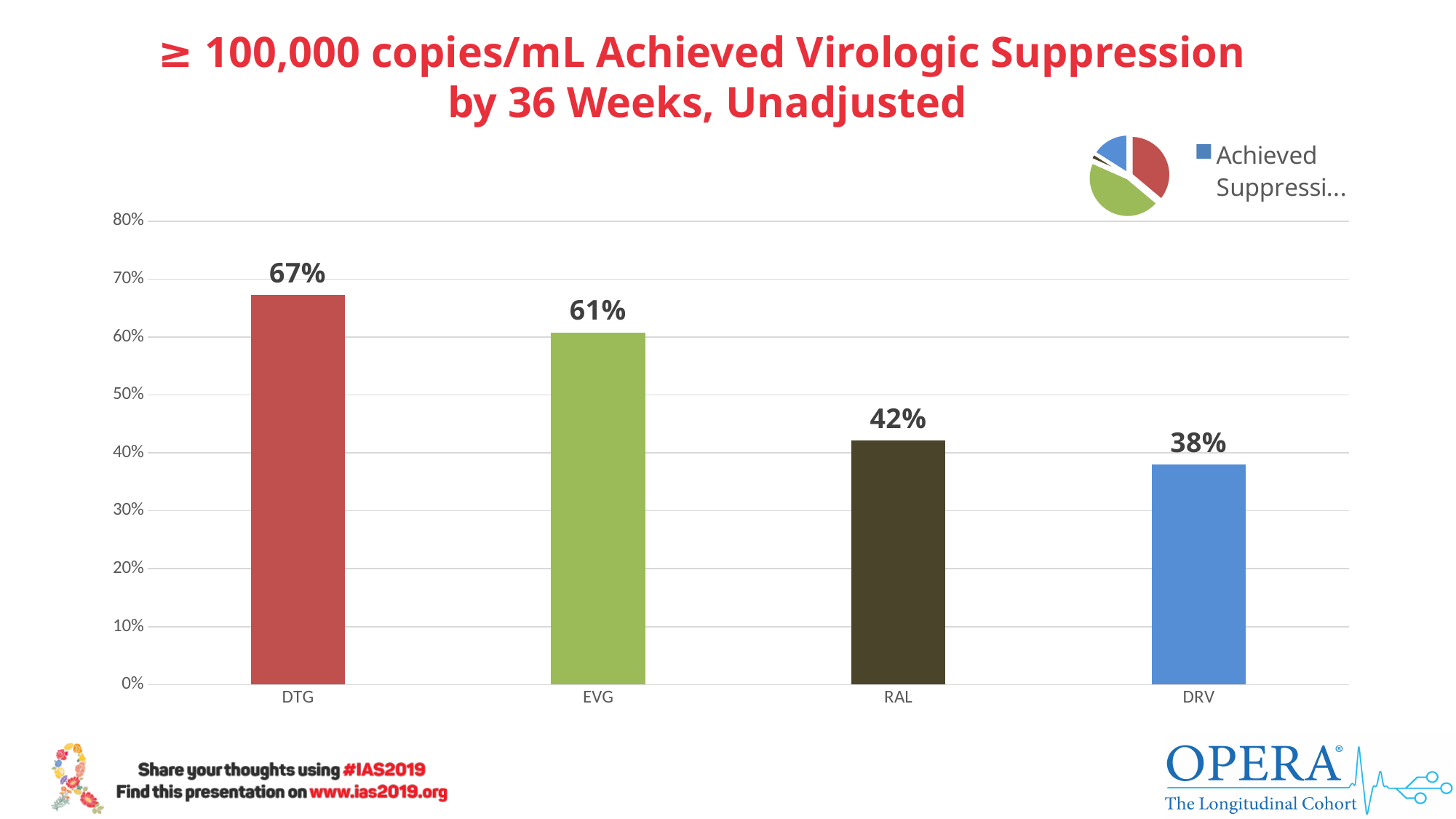
What is the difference between the values for DTG and DRV? 29% What is the value for RAL? 42% How many categories are shown on the x axis? 4 What is the value for EVG? 61% What is the difference between the values for EVG and RAL? 19% What kind of chart is this? Bar chart Do the values rise or fall from left to right along the x axis? Fall Which category has the highest value? DTG Which category has the lowest value? DRV Which is larger, the value for EVG or the value for RAL? EVG What is the value for DTG? 67% What is the value for DRV? 38%